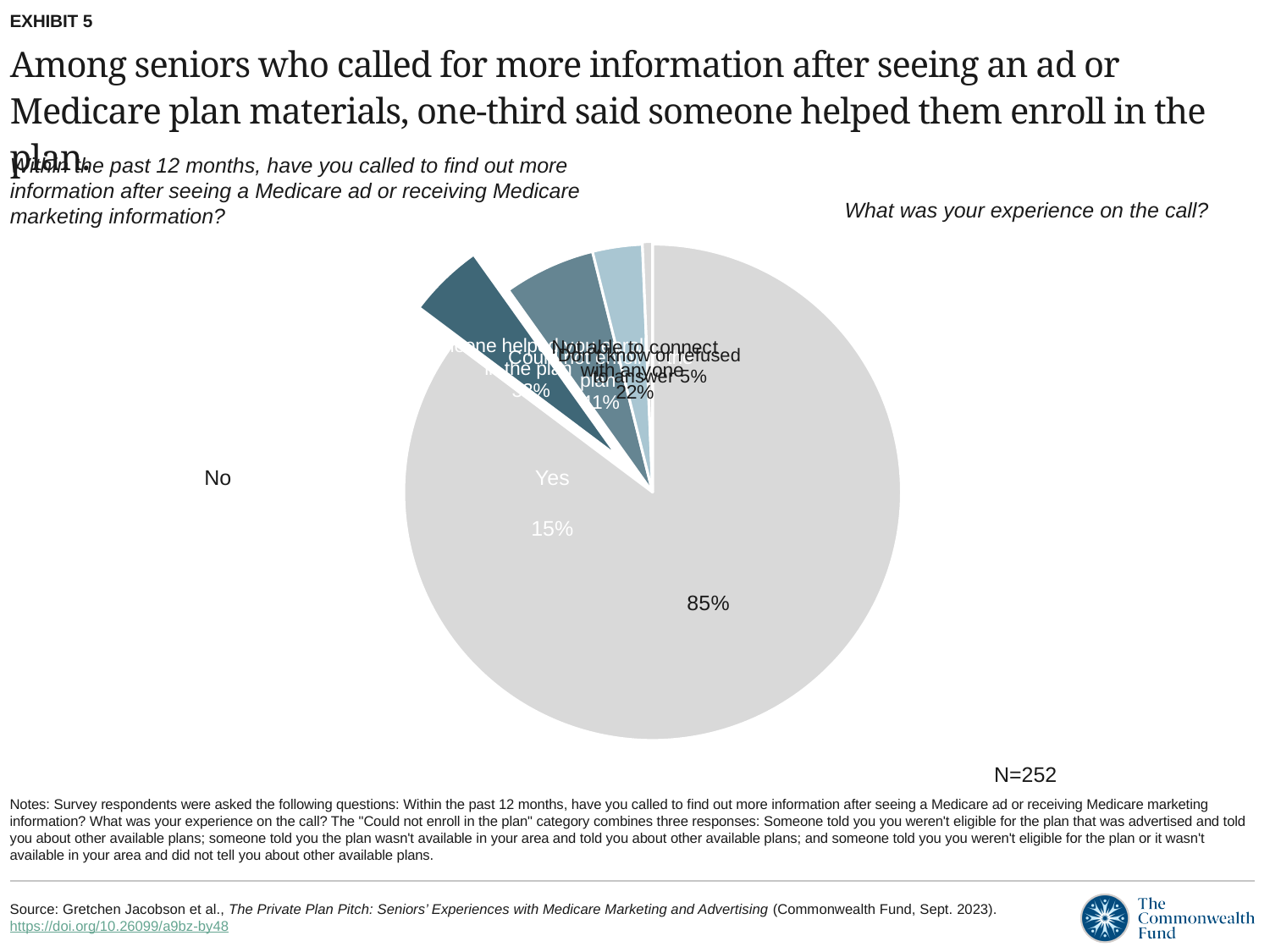
What percentage of seniors answered "No" to having called for more information in the past 12 months? 85% What percentage of callers said they don't know or refused to answer about their experience on the call? 5% What exhibit number is shown at the top of the slide? Exhibit 5 Which slice of the pie is the largest? No What is the sample size (N) shown for the chart? N=252 What is the difference in percentage points between the "No" share and the "Yes" share? 70 percentage points What kind of chart is shown on the slide? Pie chart What share of the pie is labelled "No"? 85% Which is larger, the share answering "Yes" or the share answering "No"? No What percentage of seniors answered "Yes" to having called for more information in the past 12 months? 15%